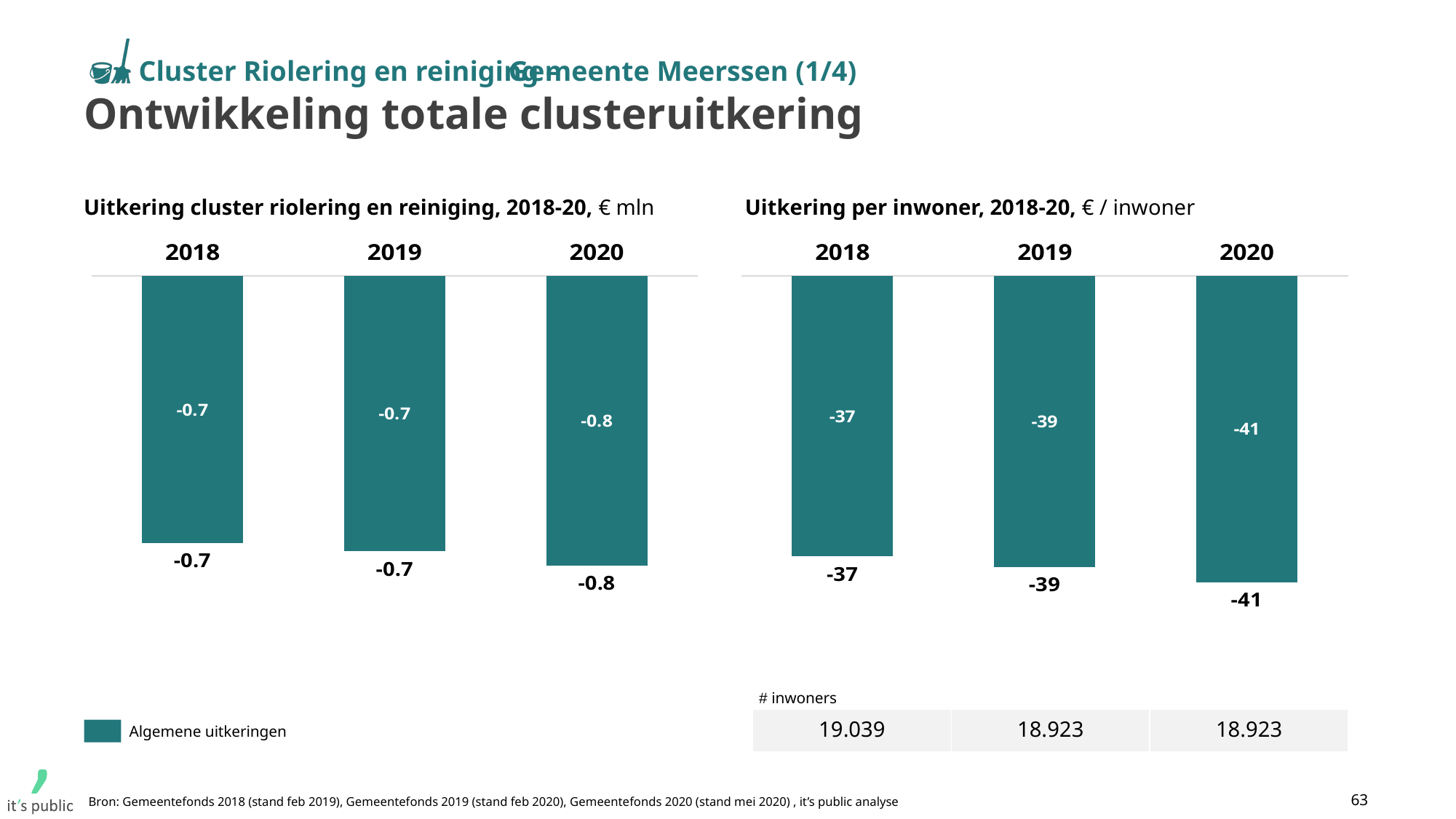
In the chart 'Uitkering per inwoner, 2018-20', do the values rise or fall from 2018 to 2020? Fall In the chart 'Uitkering cluster riolering en reiniging, 2018-20', what is the value for 2018? -0.7 In the chart 'Uitkering per inwoner, 2018-20', which year has the highest (least negative) value? 2018 In the chart 'Uitkering per inwoner, 2018-20', is the value for 2018 or for 2019 more negative? 2019 What series name does the legend on the slide show? Algemene uitkeringen In the chart 'Uitkering per inwoner, 2018-20', what is the value for 2019? -39 How many years are shown in the chart 'Uitkering cluster riolering en reiniging, 2018-20'? 3 In the chart 'Uitkering per inwoner, 2018-20', what is the value for 2020? -41 In the chart 'Uitkering per inwoner, 2018-20', what is the difference between the 2018 value and the 2020 value? 4 What kind of chart is 'Uitkering per inwoner, 2018-20'? Bar chart In the chart 'Uitkering cluster riolering en reiniging, 2018-20', what is the value for 2020? -0.8 In the chart 'Uitkering per inwoner, 2018-20', which year has the lowest (most negative) value? 2020